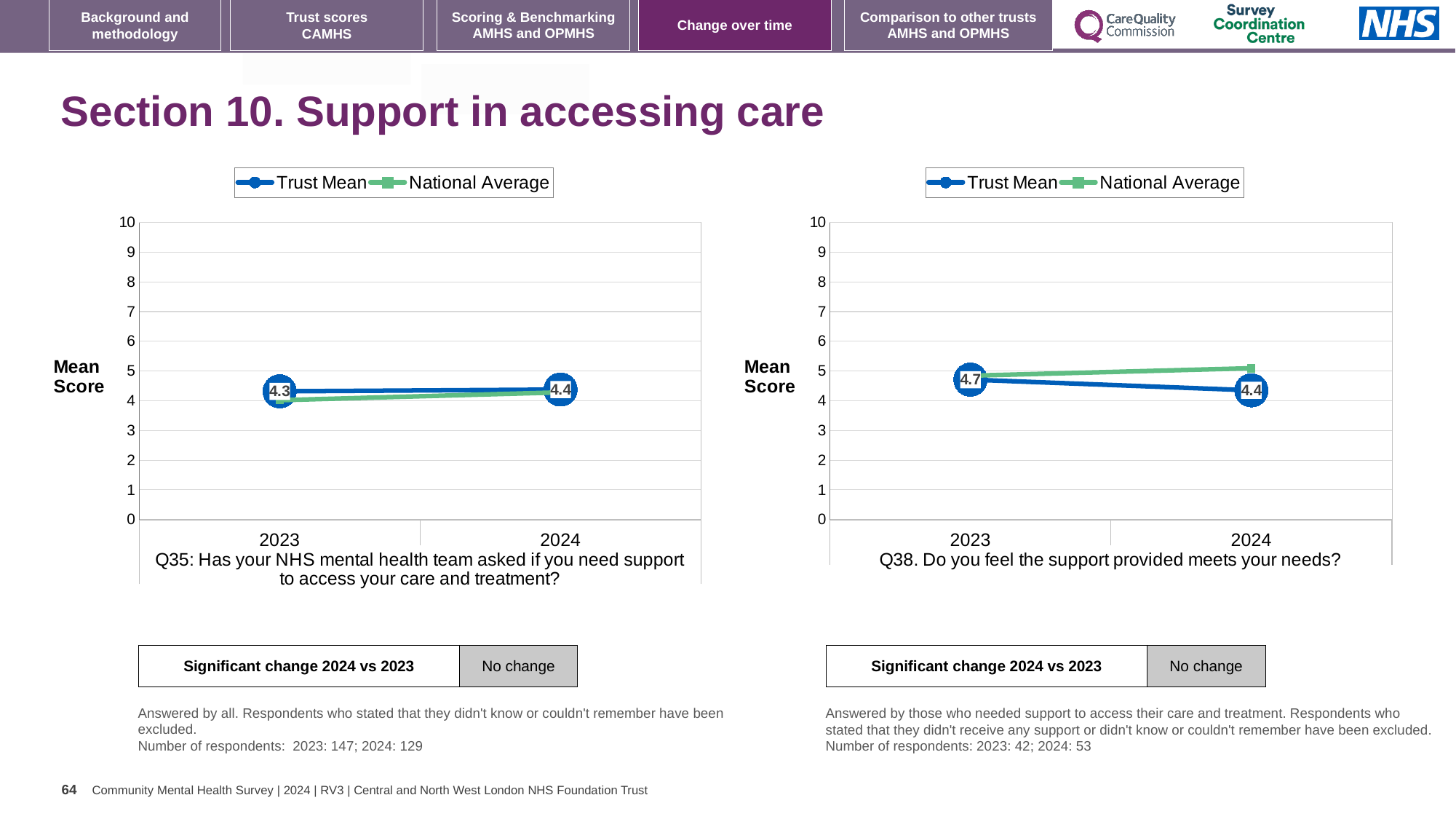
In the Q38 chart (right), does the Trust Mean rise or fall from 2023 to 2024? fall In the Q38 chart (right), which series has the higher value in 2024, Trust Mean or National Average? National Average How many years are shown on the x axis of the Q35 chart (left)? 2 In the Q38 chart (right), by how much did the Trust Mean change from 2023 to 2024? 0.3 In the Q35 chart (left), what is the Trust Mean for 2024? 4.4 In the Q35 chart (left), what is the Trust Mean for 2023? 4.3 What kind of chart is the Q35 chart (left)? line chart In the Q38 chart (right), what is the Trust Mean for 2024? 4.4 In the Q35 chart (left), does the Trust Mean rise or fall from 2023 to 2024? rise How many series does the legend of the Q38 chart (right) list? 2 In the Q38 chart (right), what is the Trust Mean for 2023? 4.7